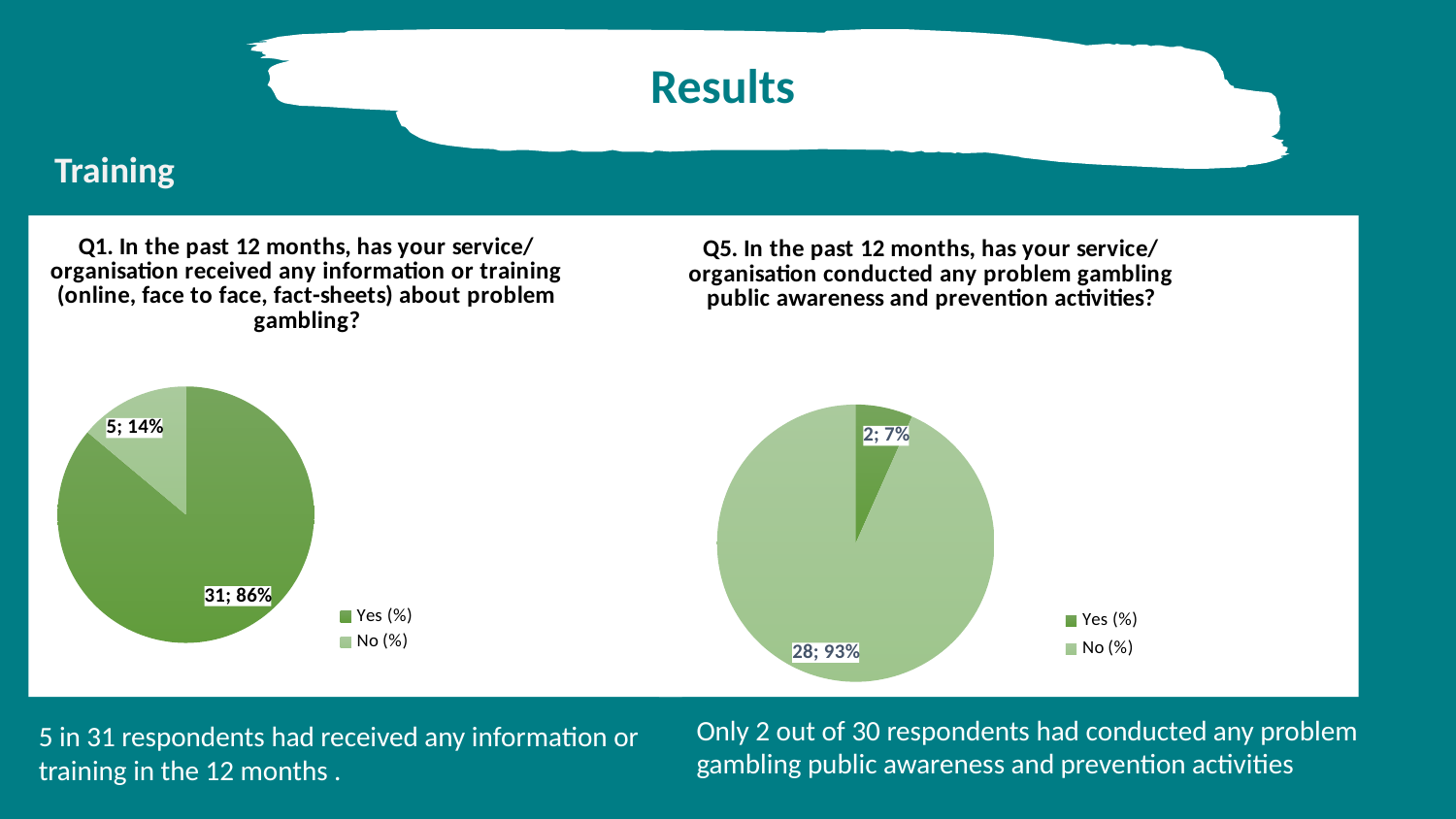
In the right pie chart (Q5), what is the data label on the 'Yes (%)' slice? 2; 7% In the right pie chart (Q5), what is the difference in count between the 'No (%)' slice and the 'Yes (%)' slice? 26 In the left pie chart (Q1), what is the data label on the 'No (%)' slice? 5; 14% How many slices does the left pie chart (Q1) have? 2 In the left pie chart (Q1), what percentage share does the 'No (%)' slice have? 14% In the left pie chart (Q1), what is the data label on the 'Yes (%)' slice? 31; 86% What type of chart is used for Q1 on the left of the slide? Pie chart In the right pie chart (Q5), what is the data label on the 'No (%)' slice? 28; 93% How many entries does the legend of the right pie chart (Q5) list? 2 In the left pie chart (Q1), which slice is larger, 'Yes (%)' or 'No (%)'? Yes (%) In the right pie chart (Q5), what percentage share does the 'No (%)' slice have? 93% In the right pie chart (Q5), which slice is the smallest? Yes (%)